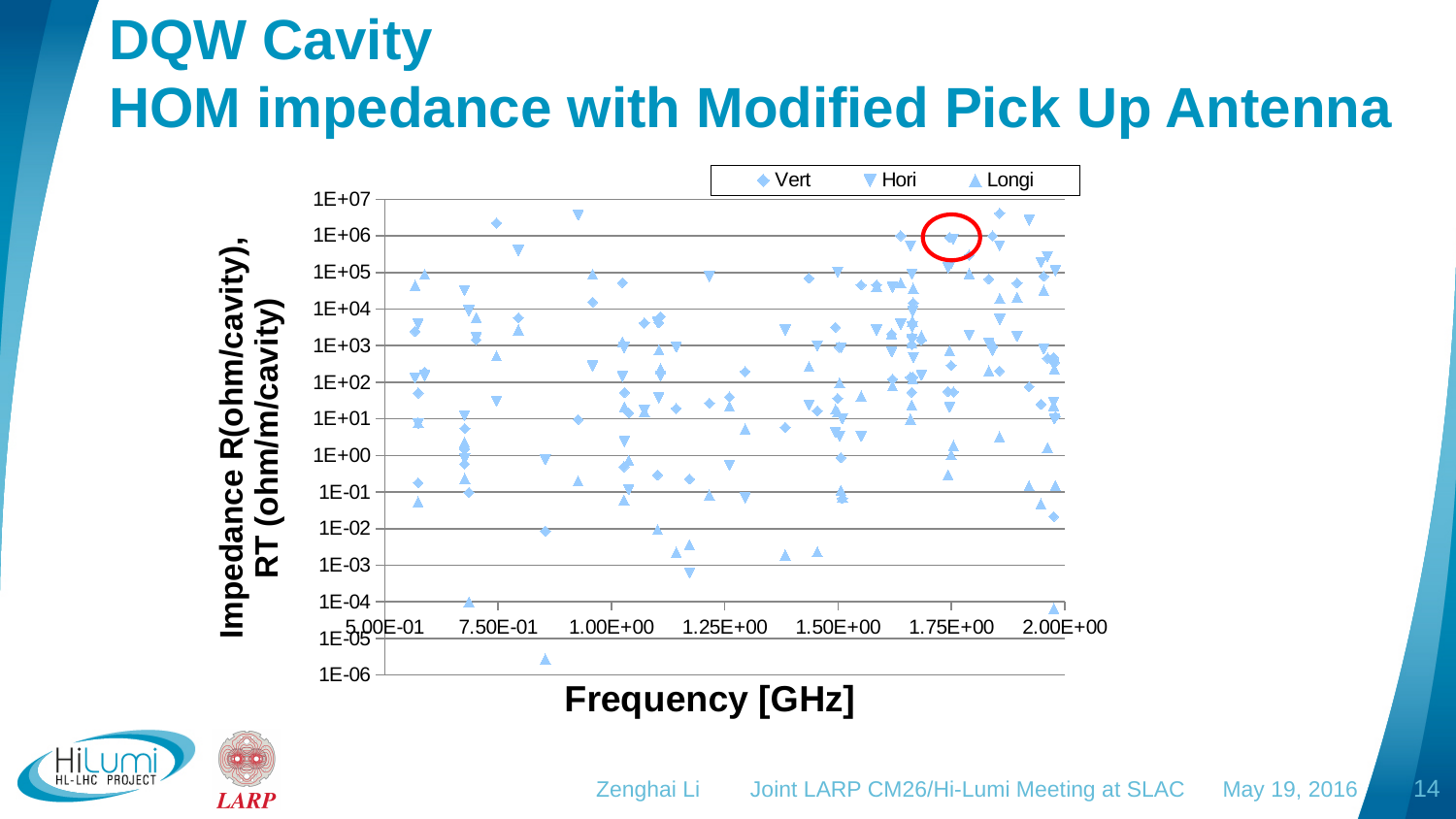
Are the points highlighted by the red circle greater or less than 1E+05? greater Is the highest plotted point on the chart greater or less than 1E+06? greater Is the lowest plotted point on the chart greater or less than 1E-04? less How many series does the legend list? 3 What kind of chart is shown on the slide? scatter chart What is the title of the x axis? Frequency [GHz] What are the names of the series listed in the legend? Vert, Hori, Longi